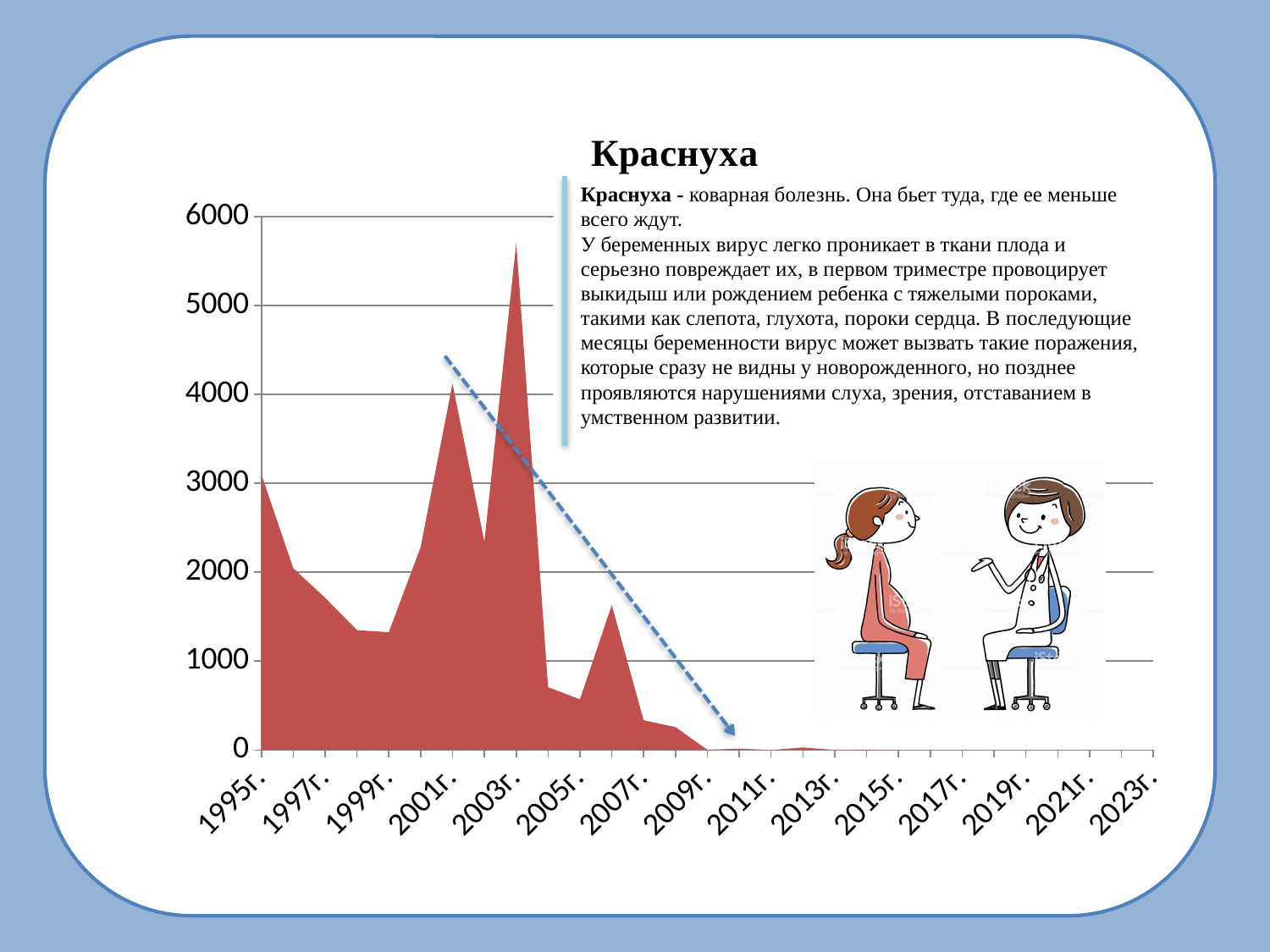
Overall, do the values rise or fall from 1995г. to 2023г.? fall Which year has the larger value, 2003г. or 2001г.? 2003г. Is the value for 2011г. greater or less than 1000? less Is the value for 1999г. greater or less than 2000? less Is the value for 2003г. greater or less than 5000? greater How many year labels are shown along the x axis? 15 What kind of chart is shown on the slide? area chart In which year does the chart reach its highest value? 2003г.